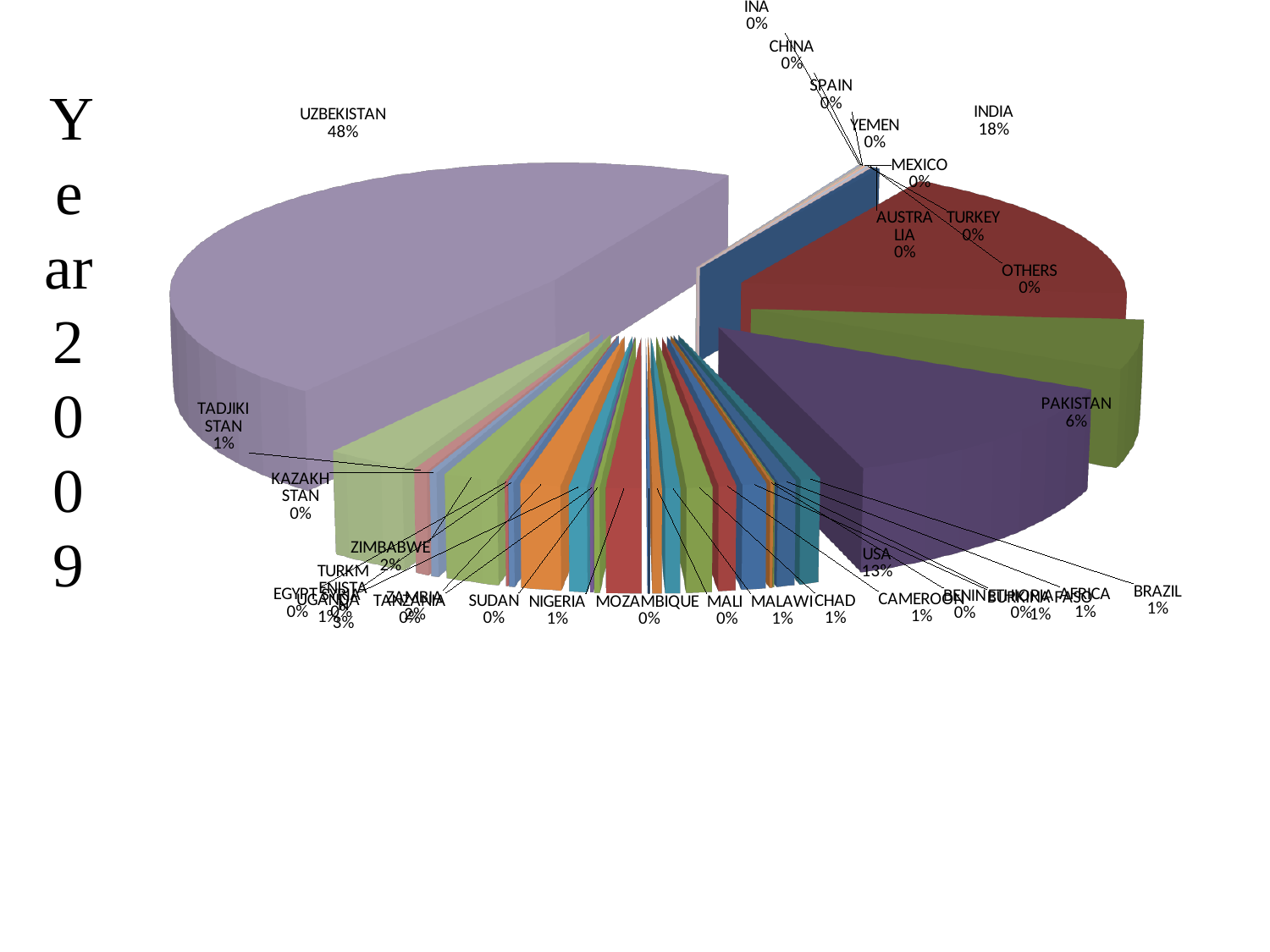
How many percentage points larger is INDIA's share than USA's? 5 Which has a larger share, INDIA or USA? INDIA How many percentage points larger is UZBEKISTAN's share than INDIA's? 30 What kind of chart is shown on the slide? pie chart What share of the pie does ZIMBABWE have? 2% What share of the pie does PAKISTAN have? 6% What share of the pie does USA have? 13% Which country has the largest share of the pie? UZBEKISTAN What is the title of the chart? Year 2009